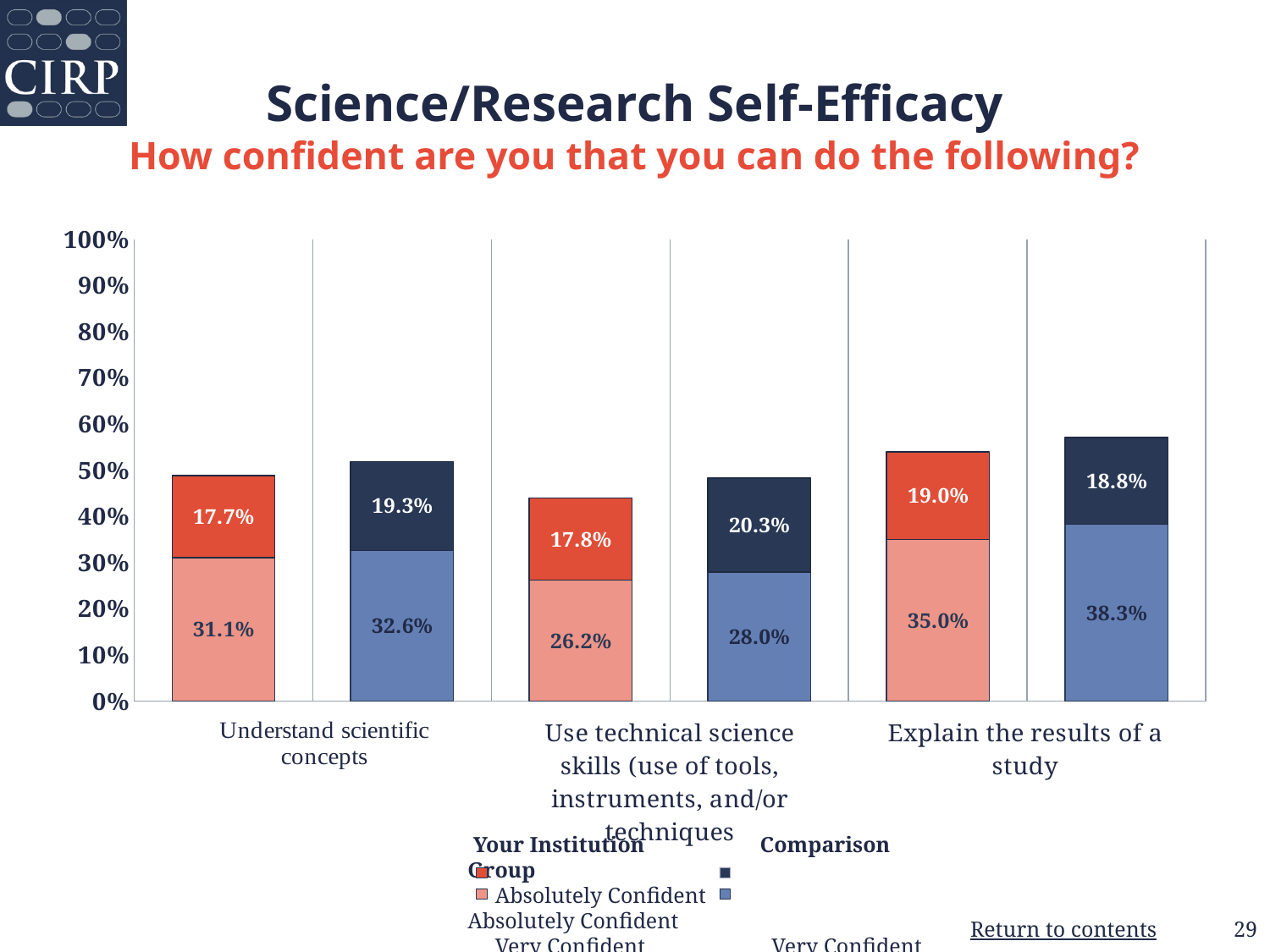
What is the total percentage (Very Confident plus Absolutely Confident) for the Comparison Group on 'Explain the results of a study'? 57.1% What percentage of Your Institution respondents are Absolutely Confident they can explain the results of a study? 35.0% How many items (categories) are shown on the x axis of the chart? 3 What percentage of the Comparison Group is Very Confident they can explain the results of a study? 18.8% What is the total percentage (Very Confident plus Absolutely Confident) for Your Institution on 'Understand scientific concepts'? 48.8% Which item has the highest Very Confident percentage for the Comparison Group? Use technical science skills For 'Explain the results of a study', which group has the larger Absolutely Confident value, Your Institution or the Comparison Group? Comparison Group What is the difference between the Comparison Group and Your Institution Very Confident values for 'Use technical science skills'? 2.5% Which item has the lowest Very Confident percentage for Your Institution? Understand scientific concepts What percentage of Your Institution respondents are Very Confident they can understand scientific concepts? 17.7% What type of chart is shown on the slide? Stacked bar chart What percentage of the Comparison Group is Absolutely Confident they can use technical science skills? 28.0%